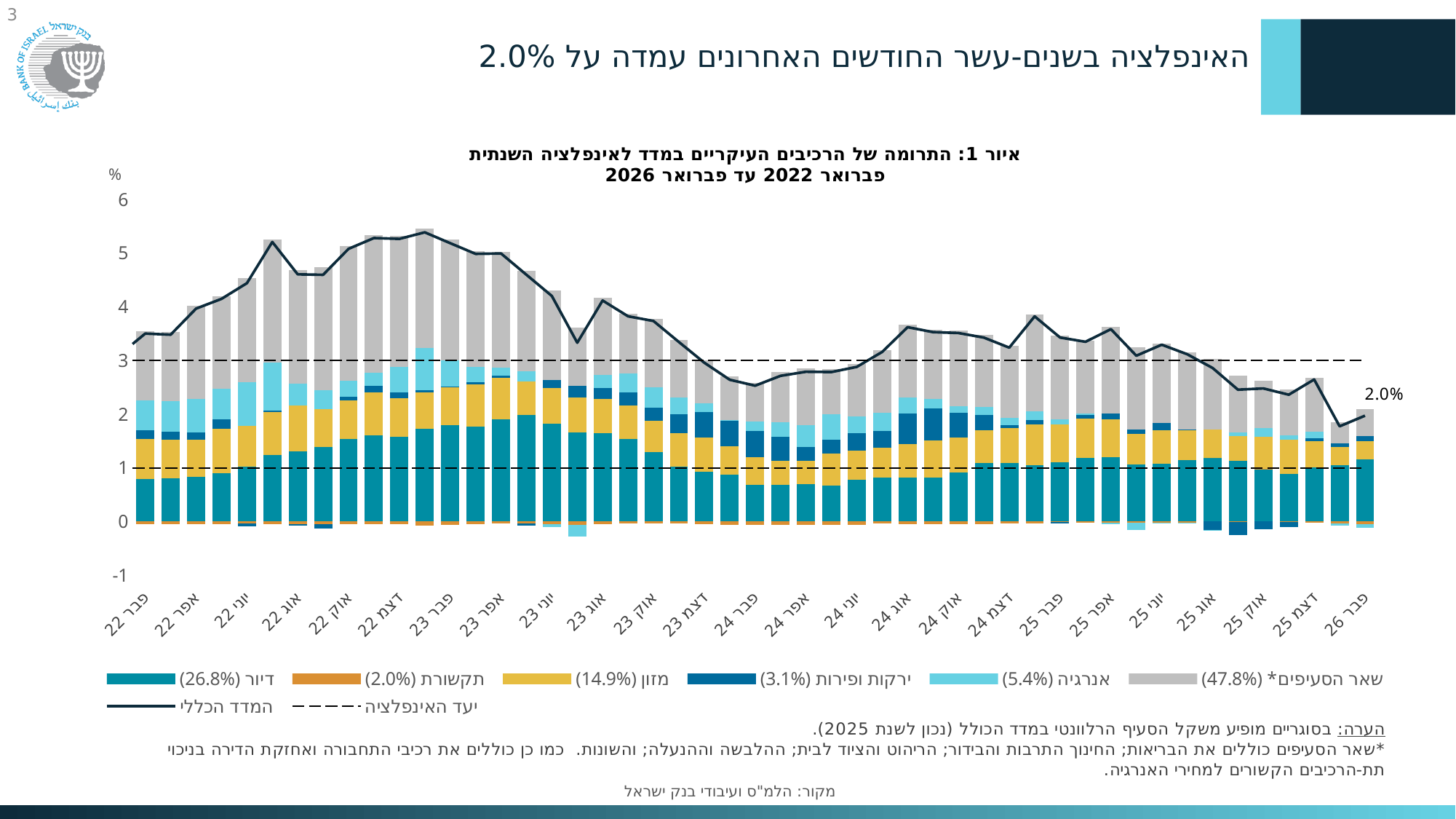
Is the value of the המדד הכללי line for פבר 23 greater or less than 5? greater What kind of chart is shown on the slide? stacked bar chart with a line Does the המדד הכללי line rise or fall between פבר 22 and פבר 23? rise Does the המדד הכללי line rise or fall between פבר 23 and פבר 24? fall What value is printed as a data label at the end of the המדד הכללי line (פבר 26)? 2.0% What weight is shown in the legend for the דיור series? 26.8% Is the value of the המדד הכללי line for פבר 25 greater or less than 3? greater What weight is shown in the legend for the שאר הסעיפים* series? 47.8% Which is larger, the המדד הכללי value for פבר 23 or for פבר 26? פבר 23 Is the value of the המדד הכללי line for פבר 22 greater or less than 3? greater How many entries does the legend list? 8